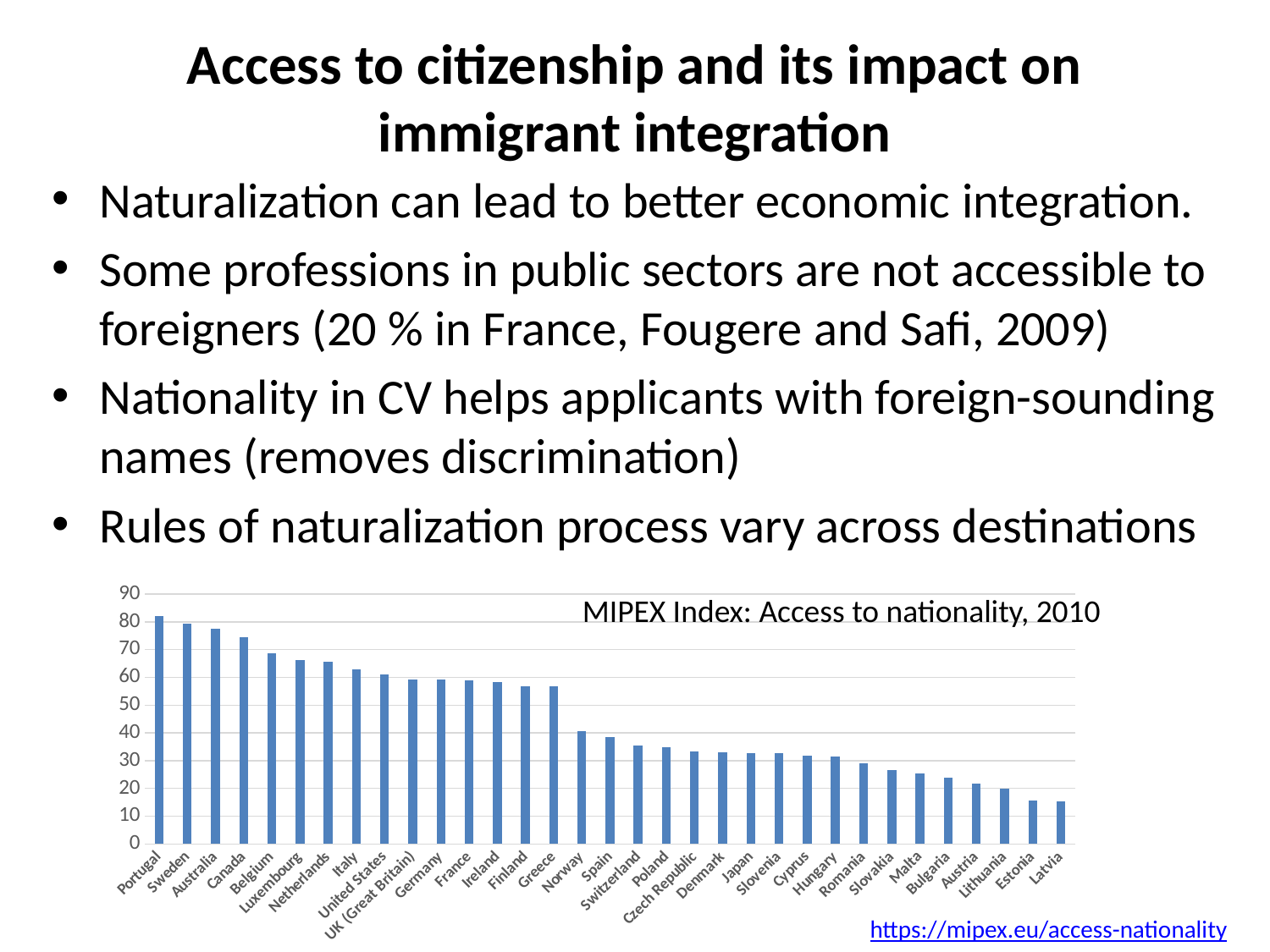
Is the value for Latvia greater or less than 20? less Is the value for Belgium greater or less than 70? less What kind of chart is shown on the slide? bar chart Is the value for Spain greater or less than 40? less Do the values in the MIPEX Index chart rise or fall from left to right along the x axis? fall Which has the larger value, Norway or Greece? Greece How many countries are shown in the MIPEX Index chart? 33 What is the title of the chart on the slide? MIPEX Index: Access to nationality, 2010 Which country has the highest value in the MIPEX Index chart? Portugal Which has the larger value, Germany or Spain? Germany